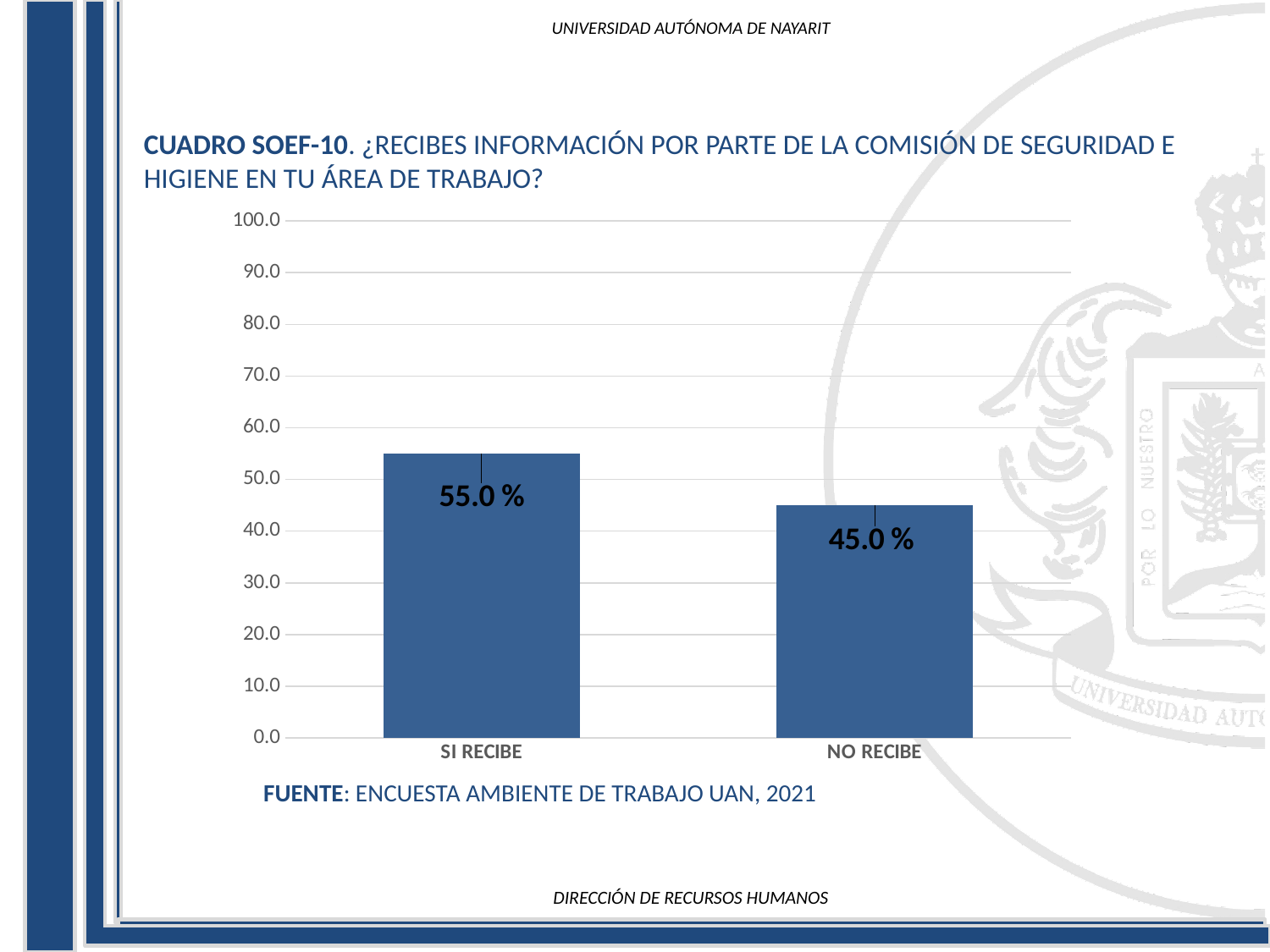
What is the value for NO RECIBE? 45.0 % What is the value for SI RECIBE? 55.0 % What kind of chart is shown on the slide? bar chart What source is cited below the chart? ENCUESTA AMBIENTE DE TRABAJO UAN, 2021 Which is larger, the value for SI RECIBE or the value for NO RECIBE? SI RECIBE Is the value for SI RECIBE greater or less than 50.0? greater Is the value for NO RECIBE greater or less than 50.0? less How many categories are shown on the x axis? 2 Which category has the lowest value? NO RECIBE What is the maximum value shown on the y axis? 100.0 What is the difference between the values for SI RECIBE and NO RECIBE? 10.0 % Which category has the highest value? SI RECIBE